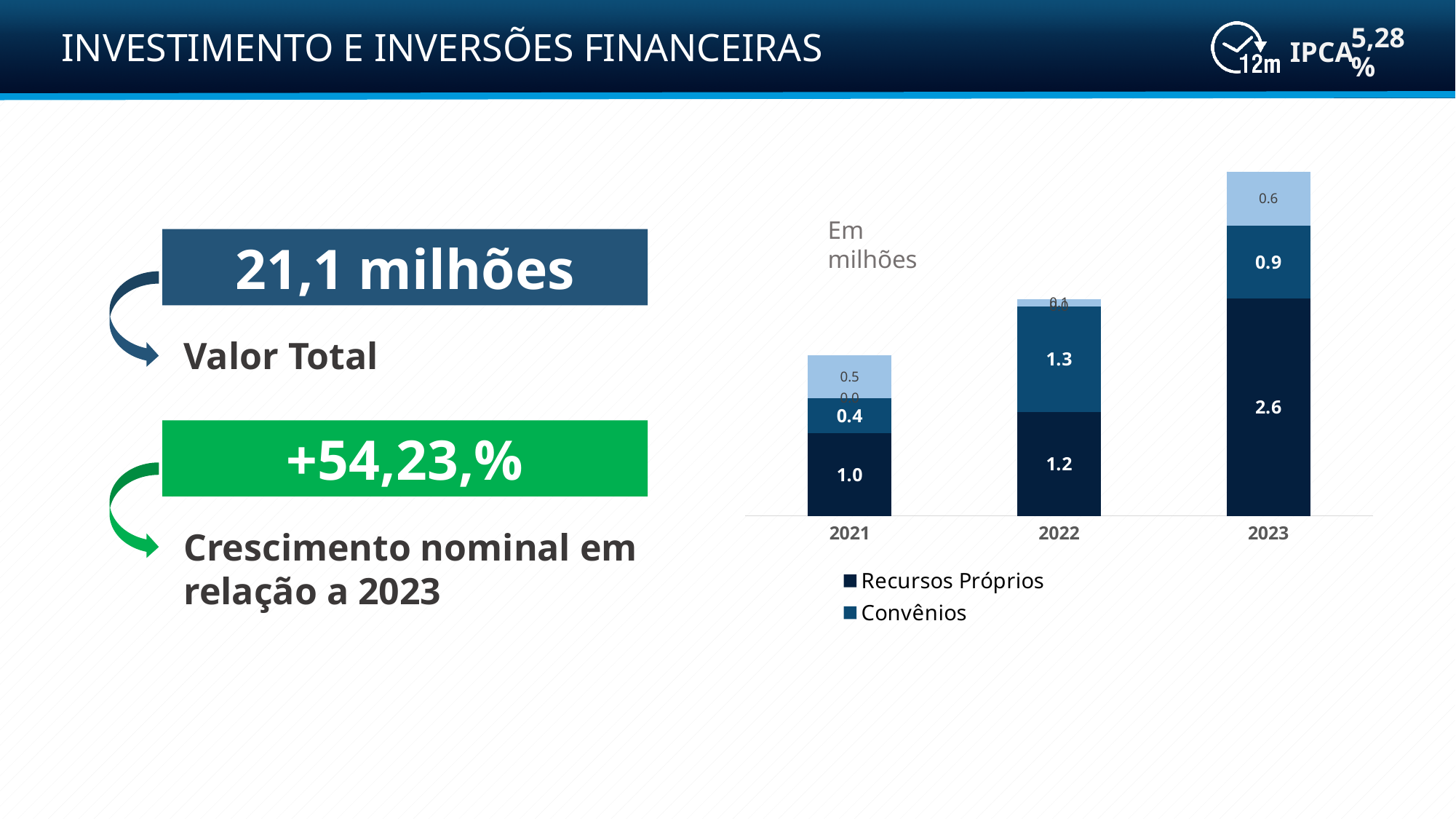
What is the value of Recursos Próprios for 2021? 1.0 What is the value of Convênios for 2022? 1.3 How many years are shown on the x axis? 3 How many series does the legend list? 2 In which year is Convênios lowest? 2021 What is the value of Convênios for 2023? 0.9 Which year has the larger Convênios value, 2022 or 2023? 2022 What is the difference between Recursos Próprios in 2023 and in 2021? 1.6 Does Recursos Próprios rise or fall from 2021 to 2023? Rise What kind of chart is shown? Stacked bar chart What is the value of Recursos Próprios for 2023? 2.6 In which year is Recursos Próprios highest? 2023